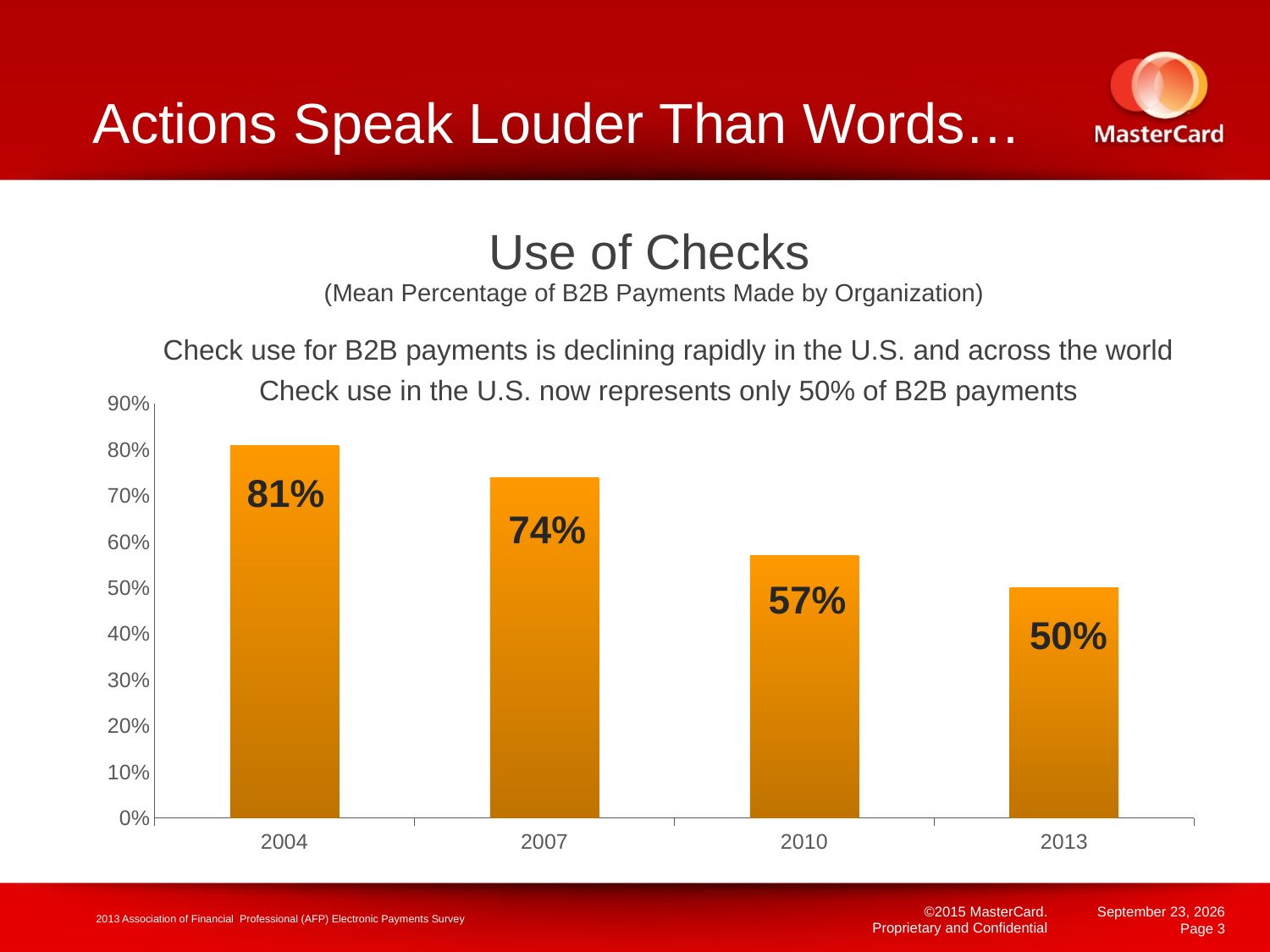
What is the difference between the values for 2004 and 2013? 31% What is the value for 2010? 57% Do the values rise or fall from 2004 to 2013? Fall What kind of chart is this? Bar chart Which year has the highest value? 2004 Which is larger, the value for 2007 or the value for 2010? 2007 What is the value for 2007? 74% What is the value for 2004? 81% How many years are shown on the x axis? 4 Which year has the lowest value? 2013 What is the difference between the values for 2007 and 2010? 17% What is the value for 2013? 50%